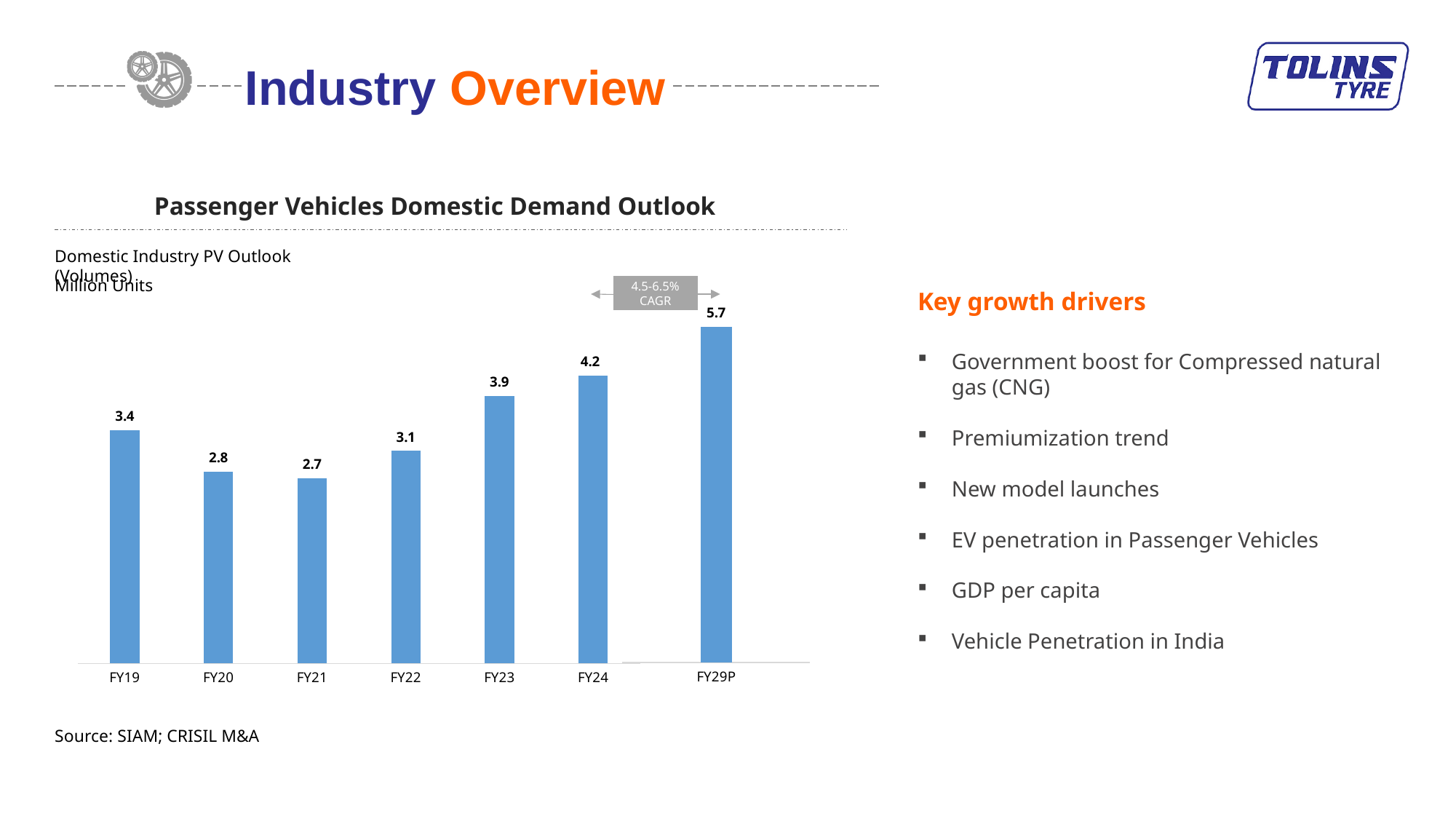
Do the values rise or fall from FY21 to FY29P? Rise What kind of chart is shown on the slide? Bar chart Which fiscal year has the lowest value? FY21 How many fiscal years are shown on the x axis? 7 What is the difference between the FY29P and FY24 values? 1.5 What is the value for FY29P? 5.7 Which fiscal year has the highest value? FY29P What is the value for FY22? 3.1 What is the value for FY19? 3.4 What is the difference between the FY24 and FY23 values? 0.3 Which is larger, the value for FY19 or the value for FY22? FY19 What CAGR range is shown between FY24 and FY29P? 4.5-6.5%